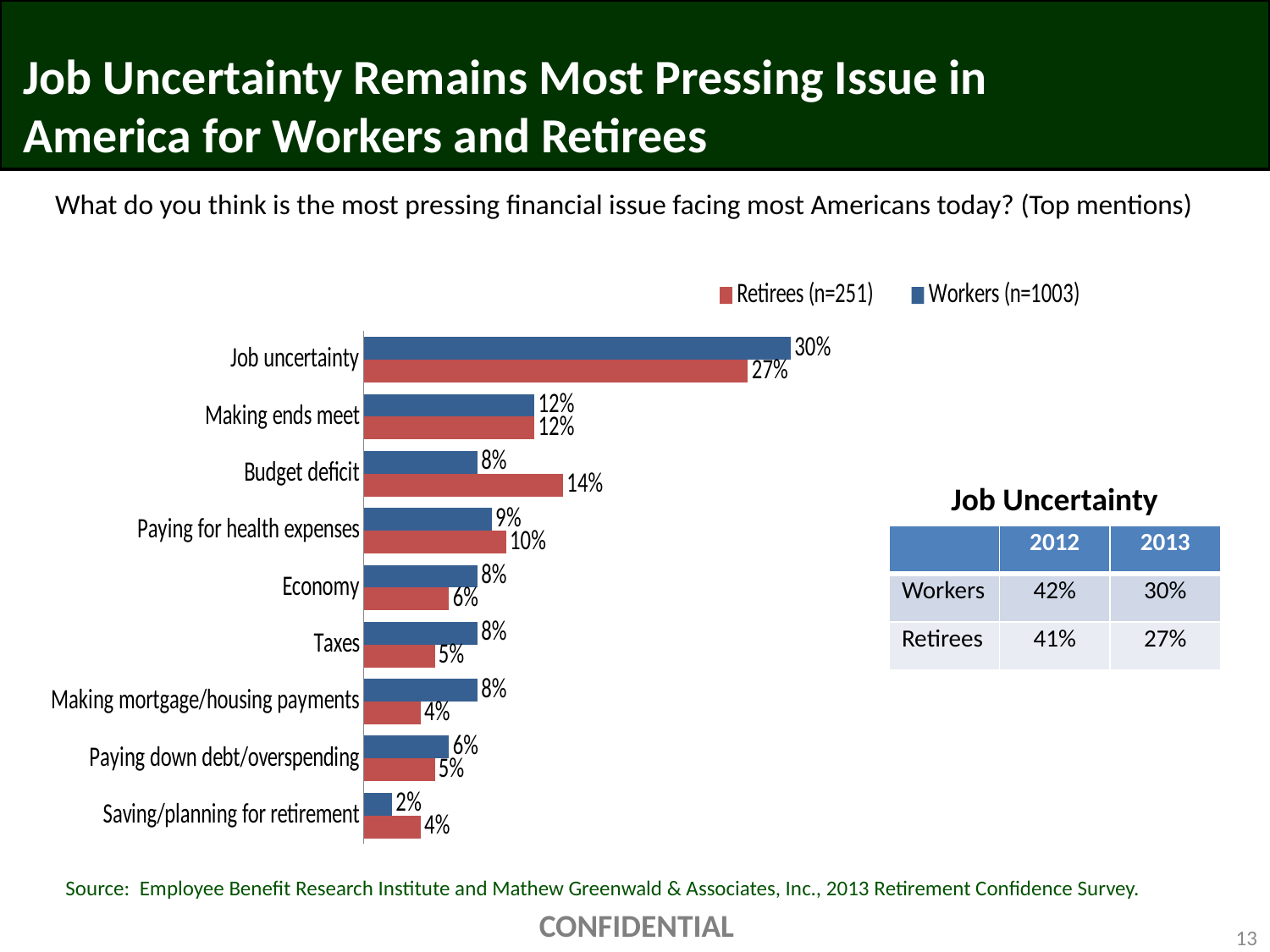
What percentage of Workers cited Job uncertainty as the most pressing financial issue? 30% What is the value for Retirees for Paying for health expenses? 10% For Saving/planning for retirement, which group has the larger value, Workers or Retirees? Retirees What is the difference between the Retirees and Workers values for Budget deficit? 6% What type of chart is used to show the most pressing financial issues? Bar chart How many categories are shown in the bar chart? 9 For Making mortgage/housing payments, which group has the larger value, Workers or Retirees? Workers Which category has the lowest value for Workers? Saving/planning for retirement How many series does the chart legend list? 2 What percentage of Retirees cited Budget deficit? 14% What is the difference between the Workers and Retirees values for Job uncertainty? 3% Which category has the highest value for Workers? Job uncertainty